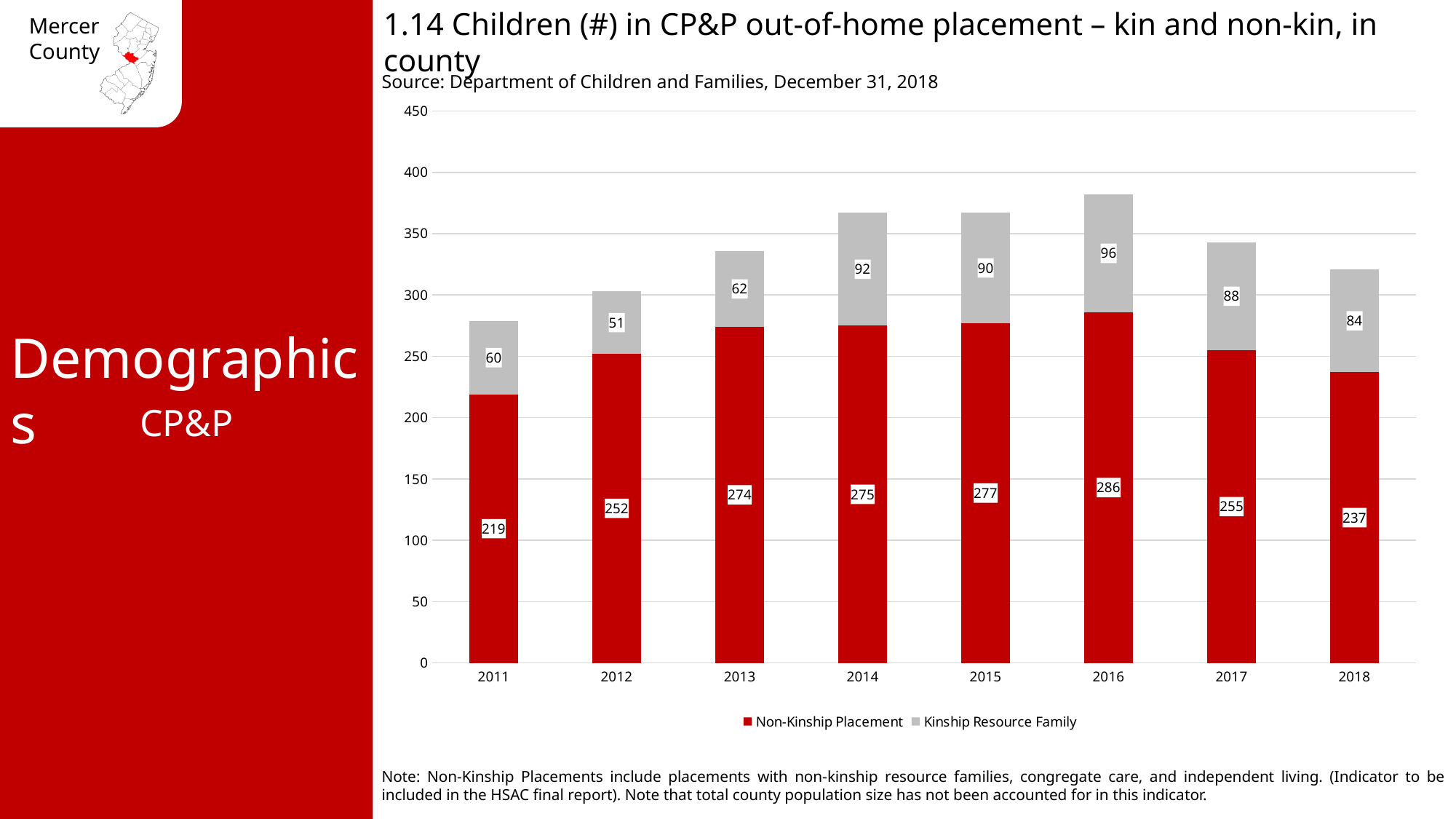
What is the total of the stacked bar for 2016? 382 What is the difference between the Non-Kinship Placement values for 2016 and 2018? 49 What is the Non-Kinship Placement value for 2016? 286 Which is larger, the Kinship Resource Family value for 2014 or for 2015? 2014 Which series is shown in red? Non-Kinship Placement What type of chart is shown on the slide? stacked bar chart Which year has the highest Non-Kinship Placement value? 2016 What is the Kinship Resource Family value for 2012? 51 Is the total of the stacked bar for 2011 greater or less than 300? less How many series does the legend list? 2 How many years are shown on the x axis? 8 Which year has the lowest Kinship Resource Family value? 2012